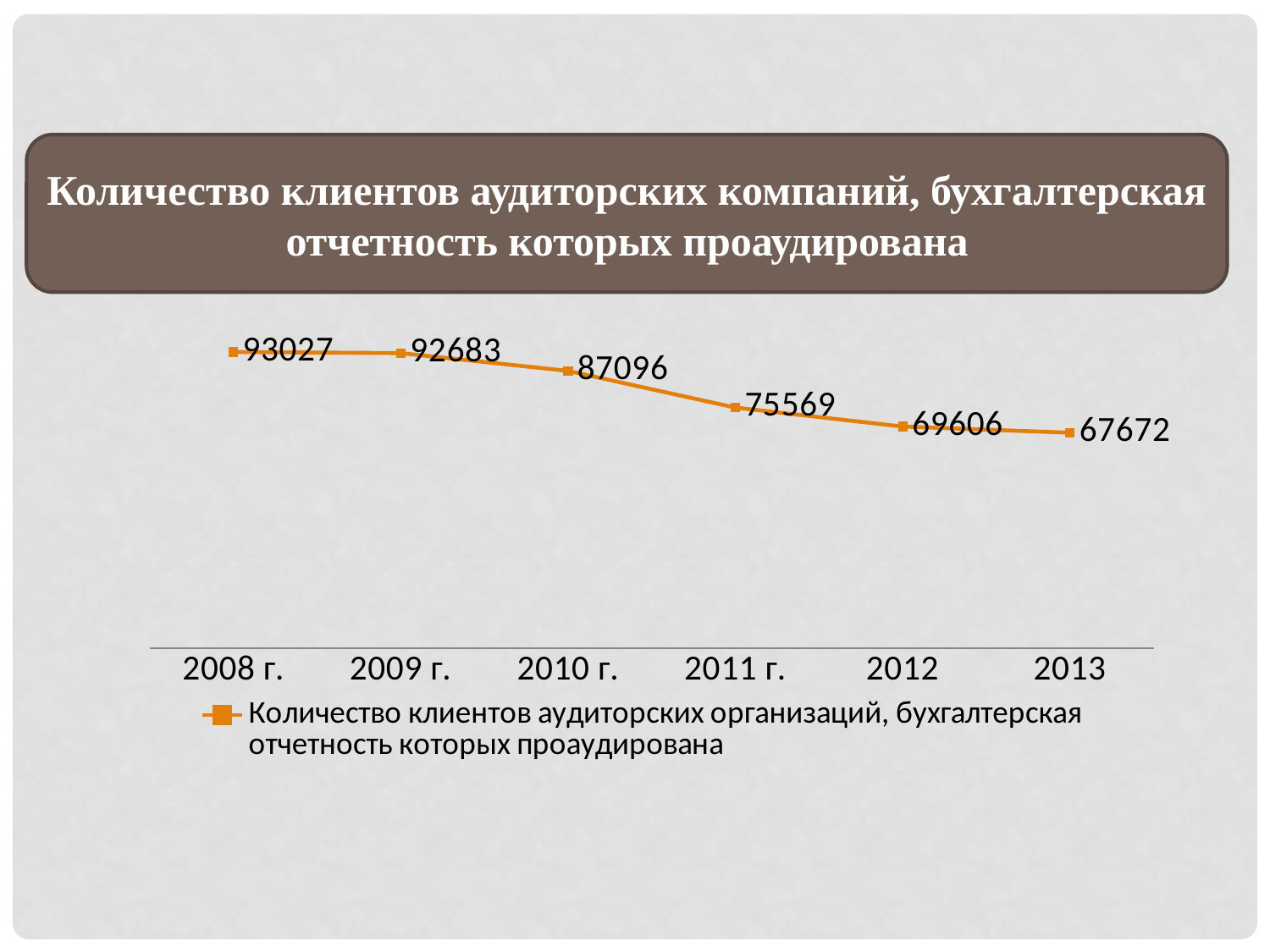
Which is larger, the value for 2009 г. or the value for 2012? 2009 г. Which year has the highest value? 2008 г. How many series does the legend list? 1 What is the value for 2011 г.? 75569 What is the difference between the values for 2010 г. and 2011 г.? 11527 Which year has the lowest value? 2013 What is the value for 2013? 67672 What is the value for 2008 г.? 93027 How many data points are plotted on the chart? 6 Do the values rise or fall from 2008 г. to 2013? fall What is the difference between the values for 2008 г. and 2013? 25355 What kind of chart is shown? line chart